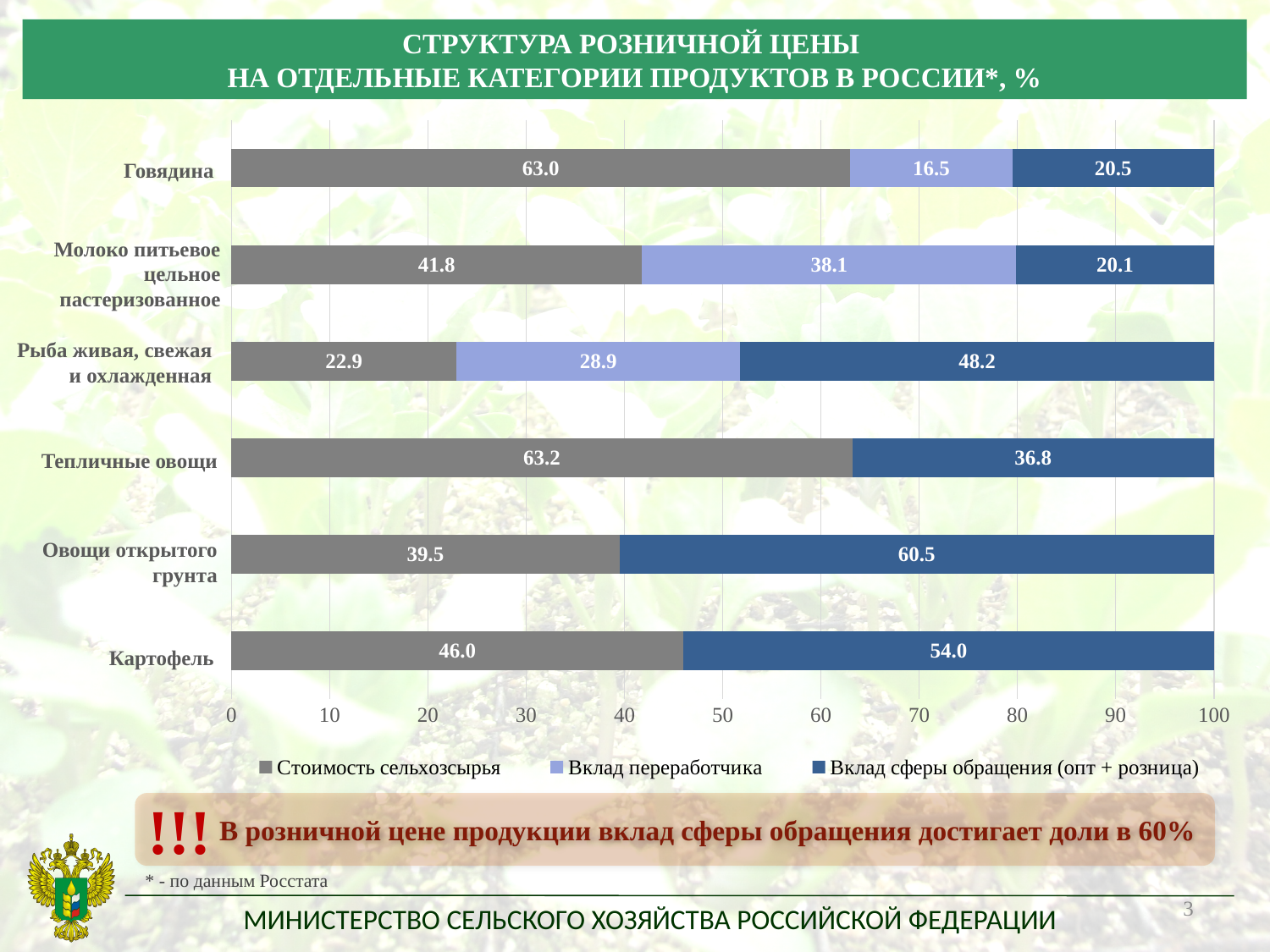
For Картофель, what is the difference between Вклад сферы обращения (опт + розница) and Стоимость сельхозсырья? 8.0 How many product categories are shown in the chart? 6 Which has the larger value for Стоимость сельхозсырья: Молоко питьевое цельное пастеризованное or Картофель? Картофель What kind of chart is shown on the slide? Stacked horizontal bar chart What is the value of Вклад переработчика for Молоко питьевое цельное пастеризованное? 38.1 What is the total of the stacked bar for Говядина? 100.0 Which category has the lowest value for Стоимость сельхозсырья? Рыба живая, свежая и охлажденная What is the value of Вклад сферы обращения (опт + розница) for Рыба живая, свежая и охлажденная? 48.2 For Рыба живая, свежая и охлажденная, how much larger is Вклад сферы обращения (опт + розница) than Вклад переработчика? 19.3 Which category has the highest value for Вклад сферы обращения (опт + розница)? Овощи открытого грунта What is the value of Стоимость сельхозсырья for Говядина? 63.0 How many series does the legend list? 3